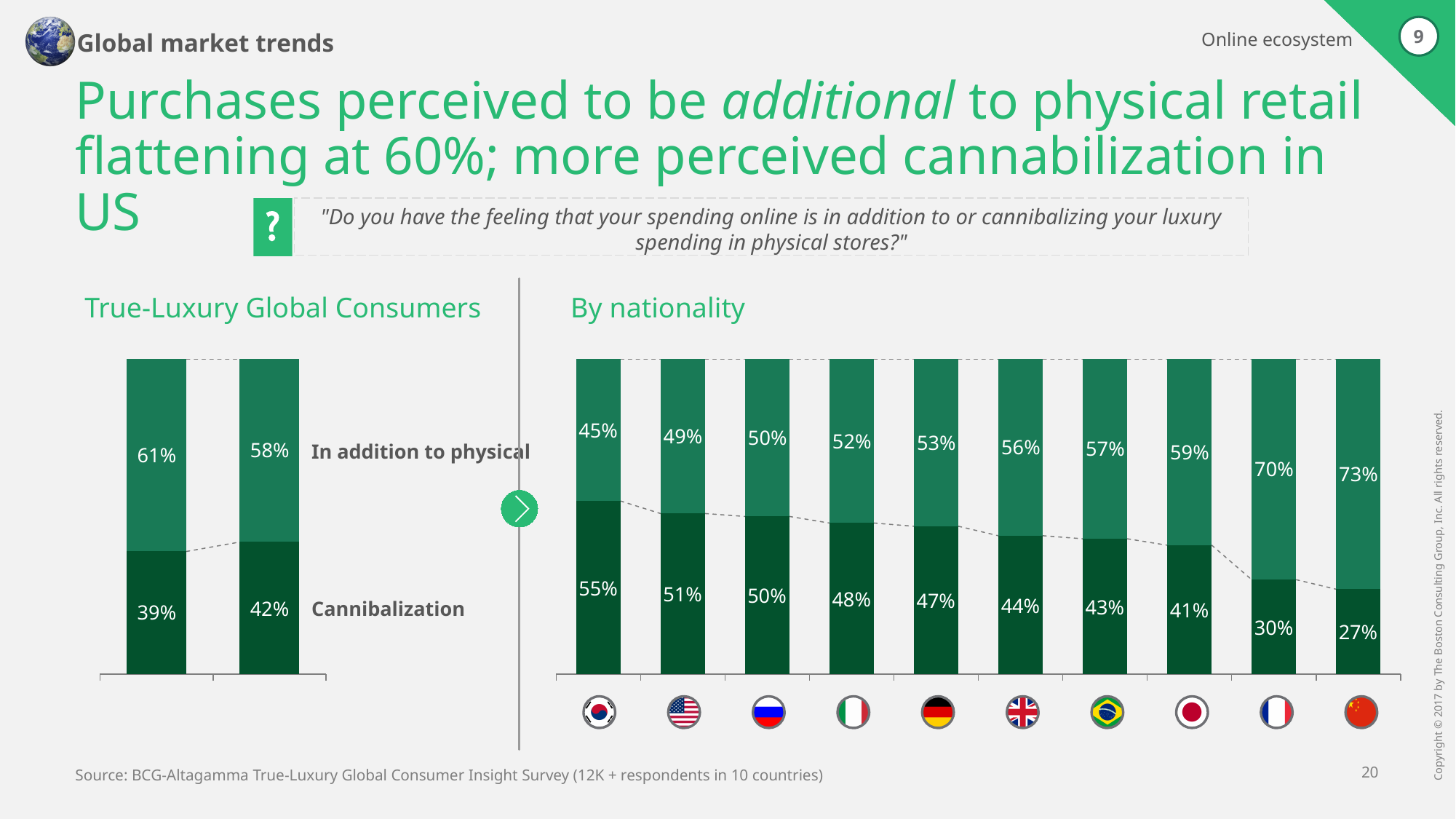
In the 'By nationality' chart, what is the 'Cannibalization' value for South Korea? 55% How many countries are shown in the 'By nationality' chart? 10 What kind of chart is the 'By nationality' chart? Stacked bar chart In the 'By nationality' chart, do the 'Cannibalization' values rise or fall from left to right? Fall In the 'By nationality' chart, which country has the highest 'Cannibalization' value? South Korea In the 'True-Luxury Global Consumers' chart, what is the 'In addition to physical' value for the right-hand bar? 58% In the 'True-Luxury Global Consumers' chart, what is the 'Cannibalization' value for the left-hand bar? 39% In the 'By nationality' chart, what is the 'In addition to physical' value for China? 73% In the 'By nationality' chart, which country has the lowest 'Cannibalization' value? China In the 'By nationality' chart, what is the difference between the 'Cannibalization' values for the United States and France? 21 percentage points In the 'By nationality' chart, what is the total of the stacked bar for Italy? 100% In the 'By nationality' chart, which has the larger 'In addition to physical' value, Japan or Germany? Japan